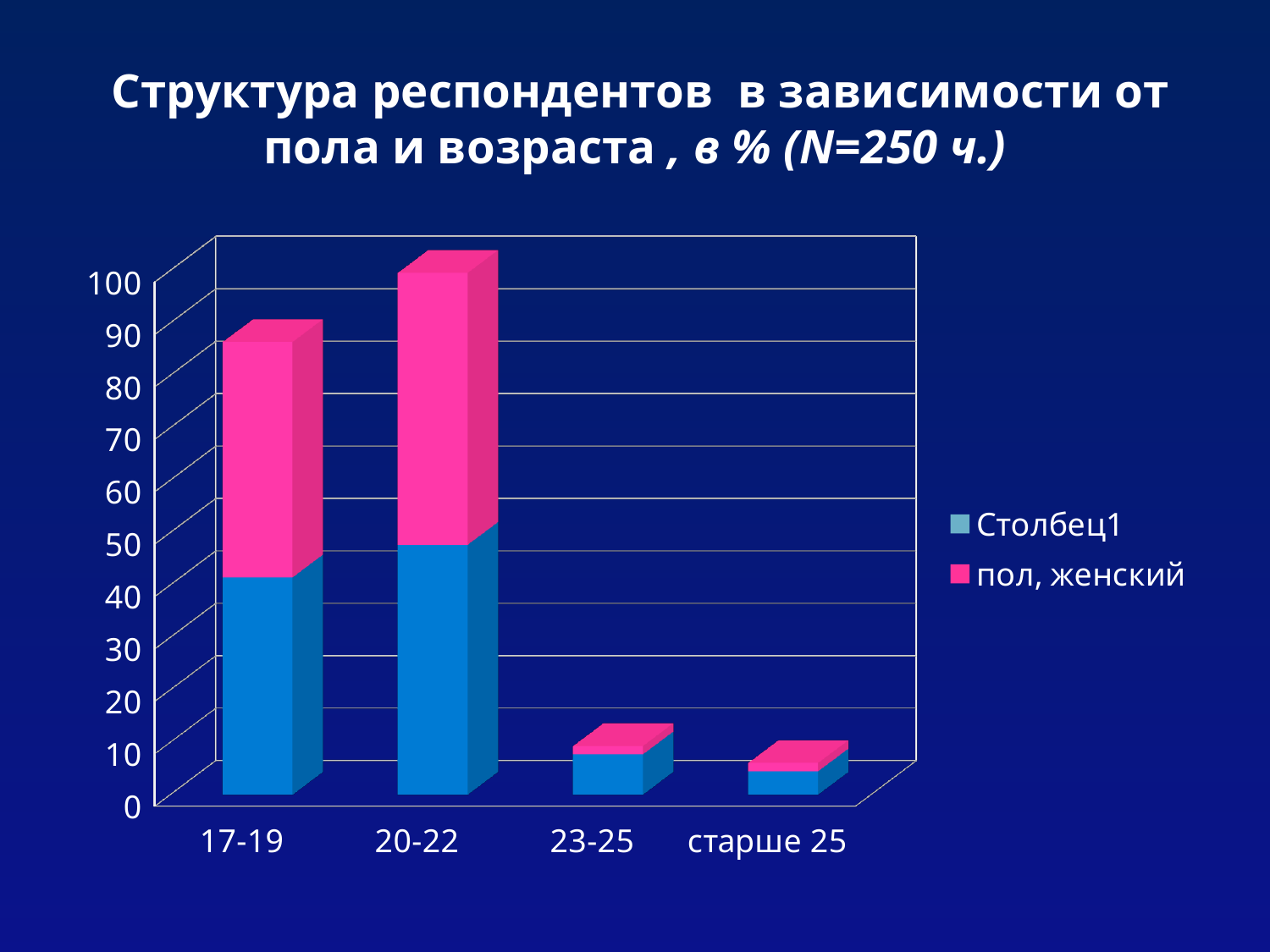
Is the total stacked bar for старше 25 greater or less than 10? less What is the title of the chart? Структура респондентов в зависимости от пола и возраста, в % (N=250 ч.) How many age categories are shown on the x axis? 4 Is the total stacked bar for 23-25 greater or less than 20? less What kind of chart is shown on the slide? stacked bar chart Is the Столбец1 segment for 17-19 greater or less than 30? greater Which age category has the shortest stacked bar? старше 25 Which legend entry is shown in pink? пол, женский Which stacked bar is taller, 17-19 or 23-25? 17-19 How many series does the legend list? 2 Which age category has the tallest stacked bar? 20-22